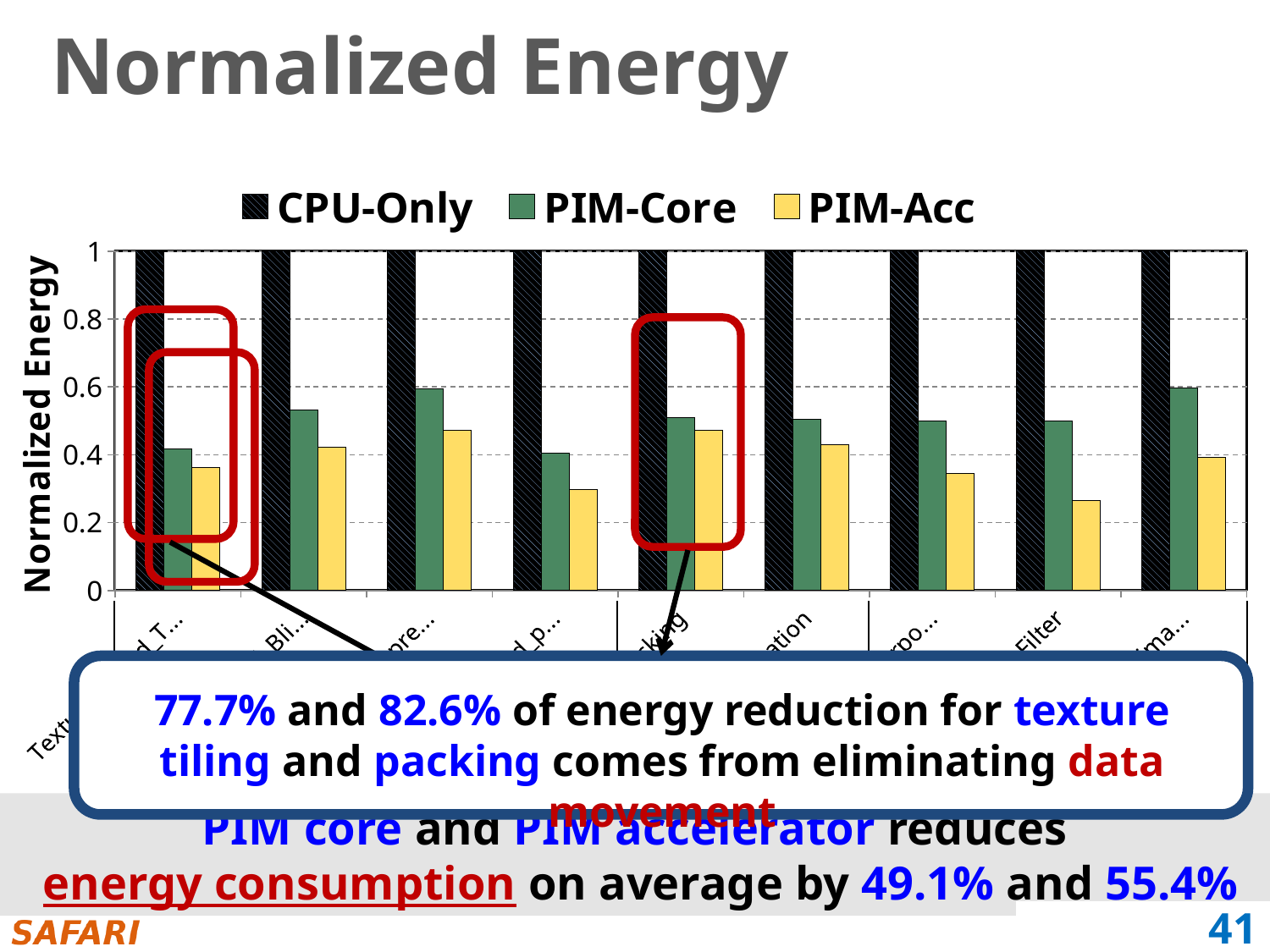
How many groups of bars (categories) are plotted? 9 For the Filter category, which is larger: the PIM-Core value or the PIM-Acc value? PIM-Core Which series has the lowest bar for the Filter category? PIM-Acc Is the PIM-Acc value for Filter greater or less than 0.2? greater Which series are listed in the legend? CPU-Only, PIM-Core, PIM-Acc Is the PIM-Core value for Filter greater or less than 0.4? greater What kind of chart is shown on the slide? bar chart Which series has the highest bar in every category? CPU-Only Is the PIM-Acc value for Filter greater or less than 0.4? less How many series does the legend list? 3 What is the normalized energy value of the CPU-Only series for the Filter category? 1 What is the label of the y axis? Normalized Energy